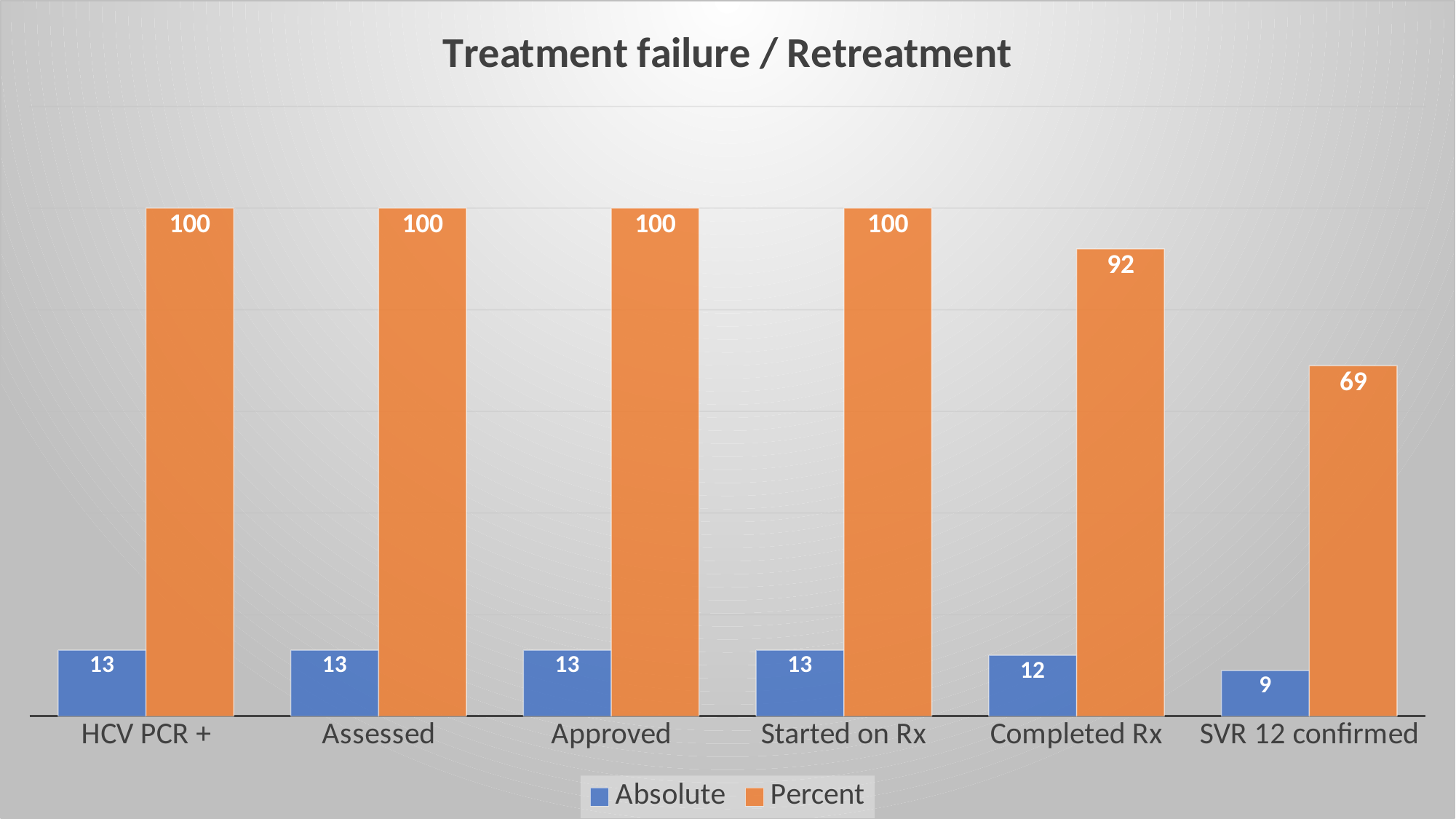
How many series does the legend list? 2 What is the difference between the Percent values for Completed Rx and SVR 12 confirmed? 23 How many categories are shown on the x axis? 6 Which is larger, the Percent value for Completed Rx or for SVR 12 confirmed? Completed Rx Which category has the lowest Absolute value? SVR 12 confirmed What is the Percent value for Completed Rx? 92 Which category has the lowest Percent value? SVR 12 confirmed What is the Percent value for SVR 12 confirmed? 69 What is the Absolute value for Completed Rx? 12 What is the difference between the Absolute values for Started on Rx and SVR 12 confirmed? 4 What is the Absolute value for SVR 12 confirmed? 9 What is the title of the chart? Treatment failure / Retreatment